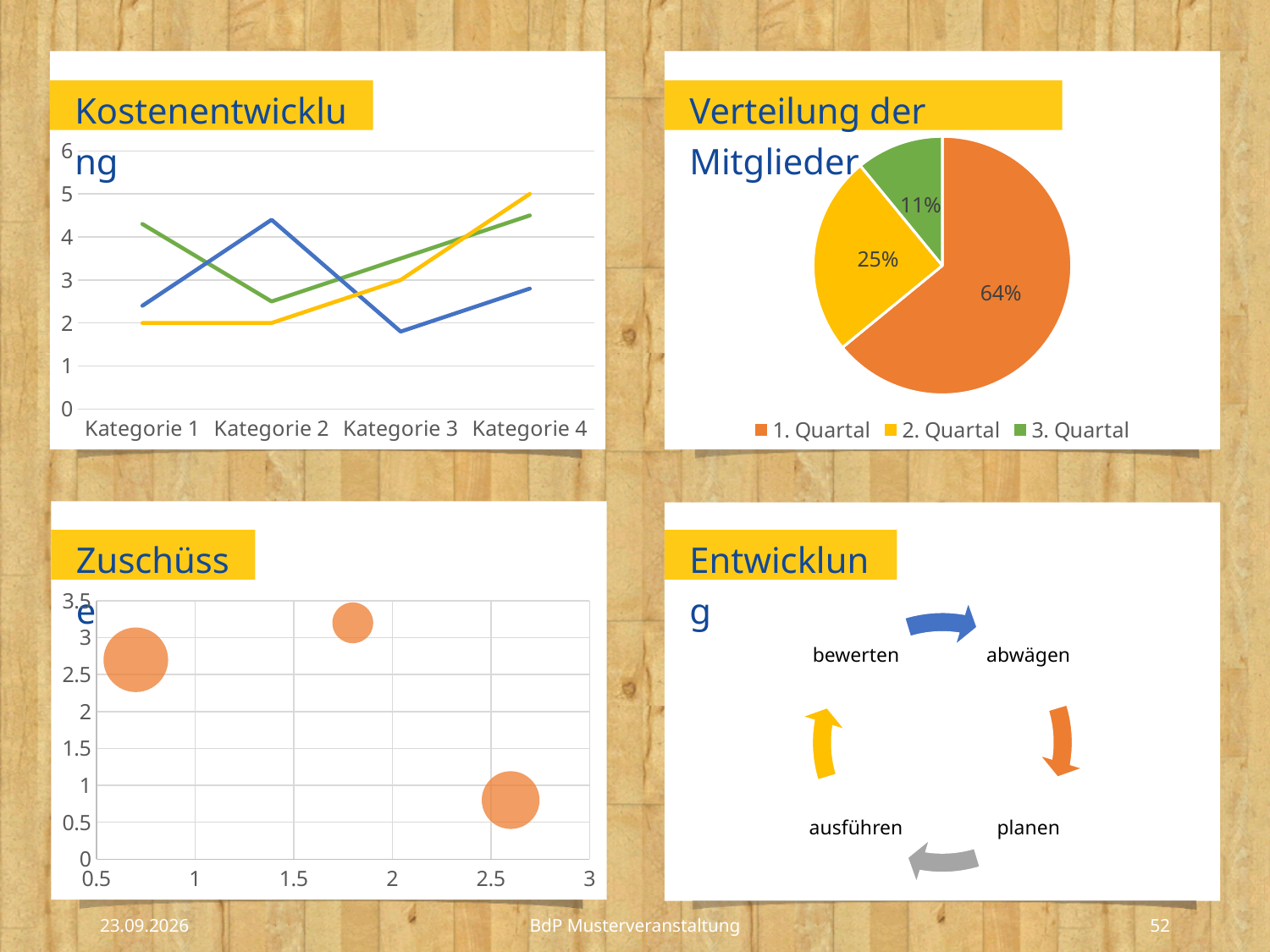
In the 'Verteilung der Mitglieder' chart, what is the difference between the shares of 1. Quartal and 2. Quartal? 39% In the 'Verteilung der Mitglieder' chart, which slice is the smallest? 3. Quartal In the 'Verteilung der Mitglieder' chart, what share does 3. Quartal have? 11% What kind of chart is 'Kostenentwicklung'? Line chart How many entries does the legend of the 'Verteilung der Mitglieder' chart list? 3 In the 'Kostenentwicklung' chart, does the yellow line rise or fall from Kategorie 2 to Kategorie 4? rise In the 'Verteilung der Mitglieder' chart, which slice is the largest? 1. Quartal How many categories are shown on the x axis of the 'Kostenentwicklung' chart? 4 In the 'Kostenentwicklung' chart, is the value of the blue line at Kategorie 2 greater or less than 4? greater What kind of chart is 'Verteilung der Mitglieder'? Pie chart How many bubbles are plotted in the 'Zuschüsse' chart? 3 In the 'Verteilung der Mitglieder' chart, what share does 1. Quartal have? 64%